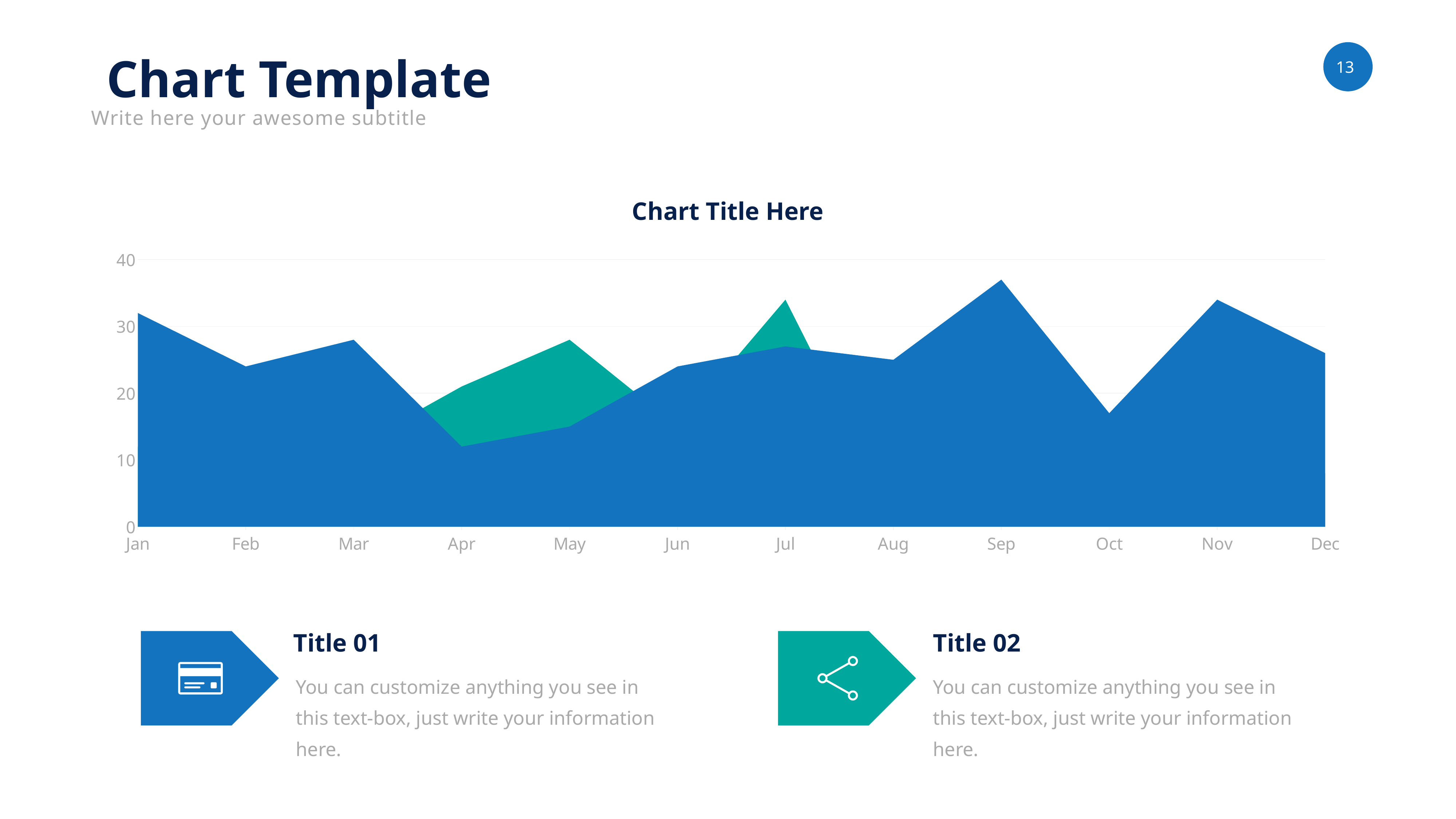
Is the value of the blue series for Apr greater or less than 20? less Is the value of the blue series for Sep greater or less than 30? greater Is the value of the blue series for Oct greater or less than 20? less Which month has the larger value for the blue series, Sep or Oct? Sep What is the highest value shown on the vertical axis of the chart? 40 Does the blue series rise or fall from Jan to Apr? fall What kind of chart is shown on the slide? area chart In which month does the blue series reach its lowest value? Apr In which month does the blue series reach its highest value? Sep What is the title of the chart? Chart Title Here How many months are shown along the x axis of the chart? 12